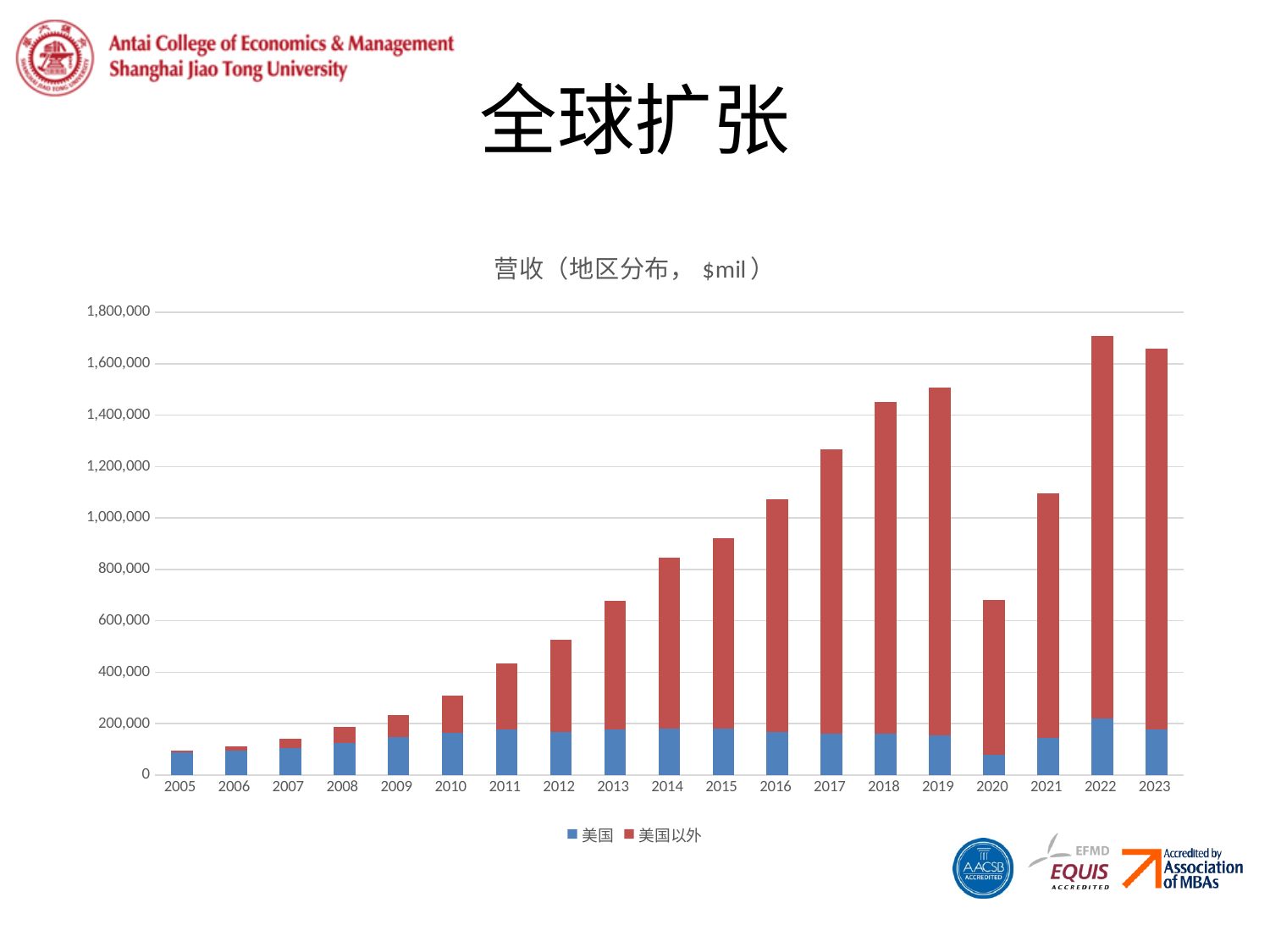
Which year has the tallest stacked bar (highest total revenue)? 2022 What is the title of the chart? 营收（地区分布，$mil） Is the total revenue for 2016 greater or less than 1,000,000? greater Is the total revenue for 2020 greater or less than 800,000? less Which year has the shortest stacked bar (lowest total revenue)? 2005 Is the total revenue for 2005 greater or less than 200,000? less How many series does the chart's legend list? 2 Which year has the larger total revenue, 2020 or 2021? 2021 Overall, do total revenues rise or fall from 2005 to 2019? rise What kind of chart is shown on the slide? Stacked bar chart How many years are shown on the x axis of the chart? 19